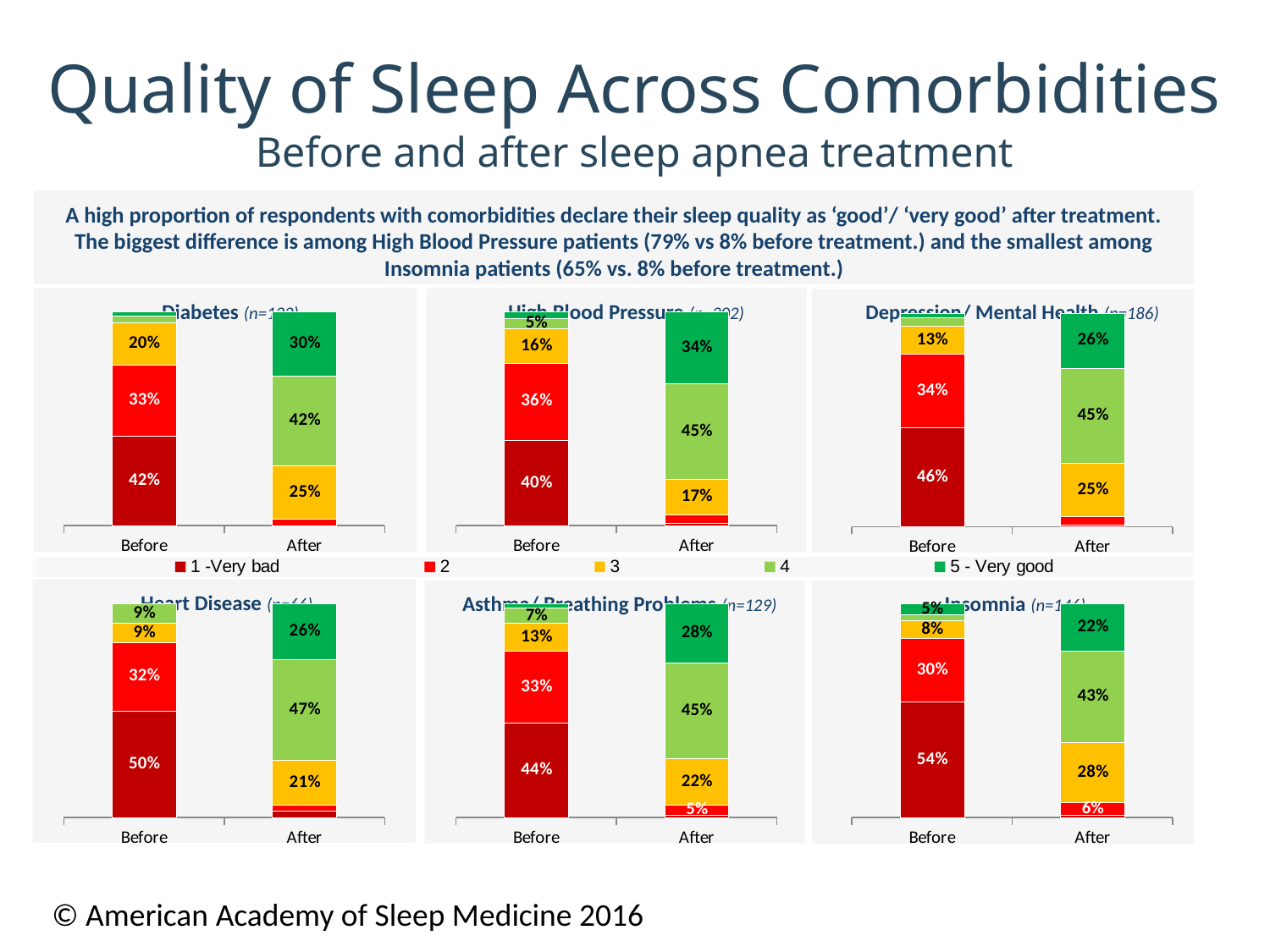
In the Heart Disease chart, what percentage of respondents rated their sleep '1 - Very bad' before treatment? 50% In the Diabetes chart, what percentage of respondents rated their sleep '1 - Very bad' before treatment? 42% What kind of chart is used for the Diabetes data? Stacked bar chart In the Asthma / Breathing Problems chart, what is the difference between the '1 - Very bad' share before treatment and the '3' share before treatment? 31% In the Insomnia chart, which is larger: the '1 - Very bad' share before treatment or the '4' share after treatment? 1 - Very bad before treatment In the Depression / Mental Health chart, what percentage of respondents rated their sleep '4' after treatment? 45% In the High Blood Pressure chart, what percentage of respondents rated their sleep '5 - Very good' after treatment? 34% Which legend entry is shown in dark green? 5 - Very good How many series does the shared legend list? 5 In the Heart Disease chart, what is the difference between the '4' share after treatment and the '5 - Very good' share after treatment? 21% How many bars does the High Blood Pressure chart show? 2 In the Insomnia chart, what percentage of respondents rated their sleep '2' after treatment? 6%